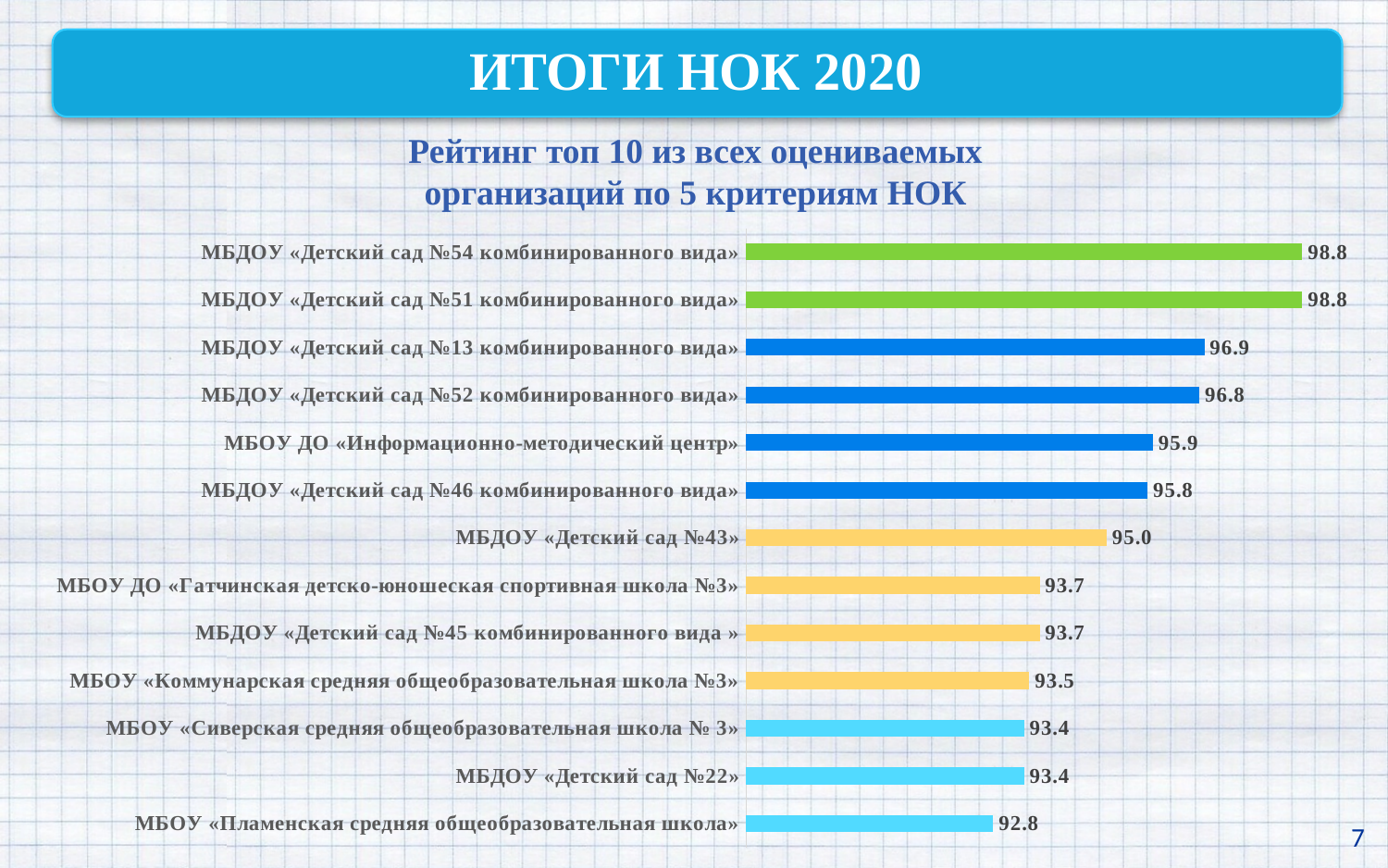
What is the value for МБДОУ «Детский сад №13 комбинированного вида»? 96.9 Which organisation has the lowest value in the chart? МБОУ «Пламенская средняя общеобразовательная школа» What kind of chart is shown on the slide? bar chart What is the difference between the value for МБДОУ «Детский сад №13 комбинированного вида» and the value for МБДОУ «Детский сад №45 комбинированного вида»? 3.2 What is the title of the chart? Рейтинг топ 10 из всех оцениваемых организаций по 5 критериям НОК How many organisations are plotted in the chart? 13 Which has the larger value: МБДОУ «Детский сад №46 комбинированного вида» or МБДОУ «Детский сад №22»? МБДОУ «Детский сад №46 комбинированного вида» Which has the larger value: МБОУ «Сиверская средняя общеобразовательная школа № 3» or МБДОУ «Детский сад №52 комбинированного вида»? МБДОУ «Детский сад №52 комбинированного вида» What is the difference between the value for МБДОУ «Детский сад №54 комбинированного вида» and the value for МБОУ «Пламенская средняя общеобразовательная школа»? 6.0 What is the value for МБОУ «Коммунарская средняя общеобразовательная школа №3»? 93.5 What is the value for МБОУ ДО «Информационно-методический центр»? 95.9 What is the value for МБДОУ «Детский сад №43»? 95.0